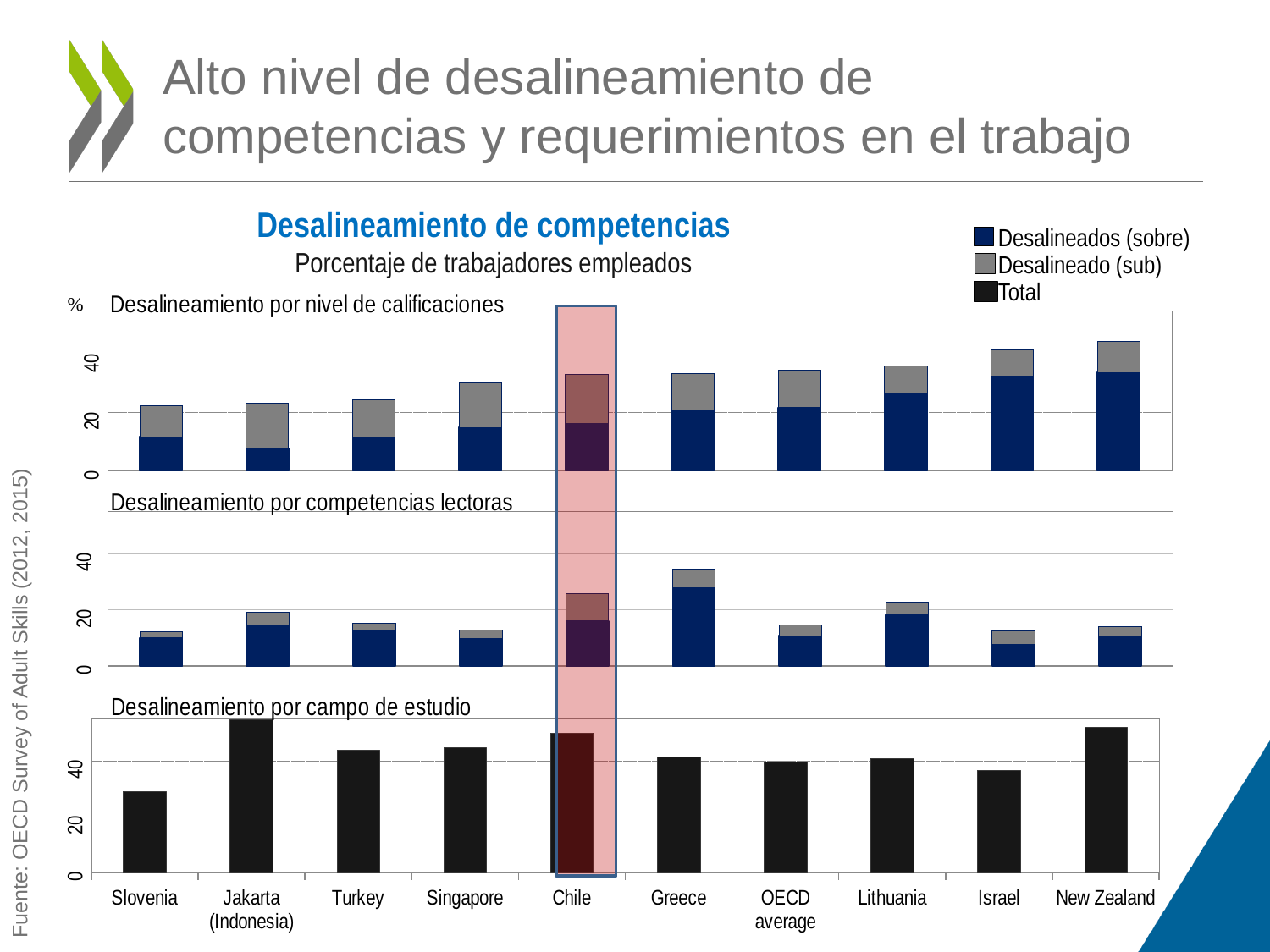
Which country is highlighted with a shaded red column across all three panels? Chile How many countries or regions are shown along the x axis of the charts? 10 In the 'Desalineamiento por competencias lectoras' panel, which has the larger total bar, Greece or Chile? Greece In the 'Desalineamiento por competencias lectoras' panel, is the total value for Chile greater or less than 40? less In the 'Desalineamiento por nivel de calificaciones' panel, is the total value for Chile greater or less than 20? greater In the 'Desalineamiento por campo de estudio' panel, which country has the lowest bar? Slovenia In the 'Desalineamiento por nivel de calificaciones' panel, do the total bar heights rise or fall from left to right? rise How many series does the legend list? 3 In the 'Desalineamiento por competencias lectoras' panel, which country has the highest total bar? Greece In the 'Desalineamiento por campo de estudio' panel, is the value for Chile greater or less than 40? greater What kind of chart is used in the 'Desalineamiento por campo de estudio' panel? bar chart In the 'Desalineamiento por nivel de calificaciones' panel, which country has the highest total bar? New Zealand